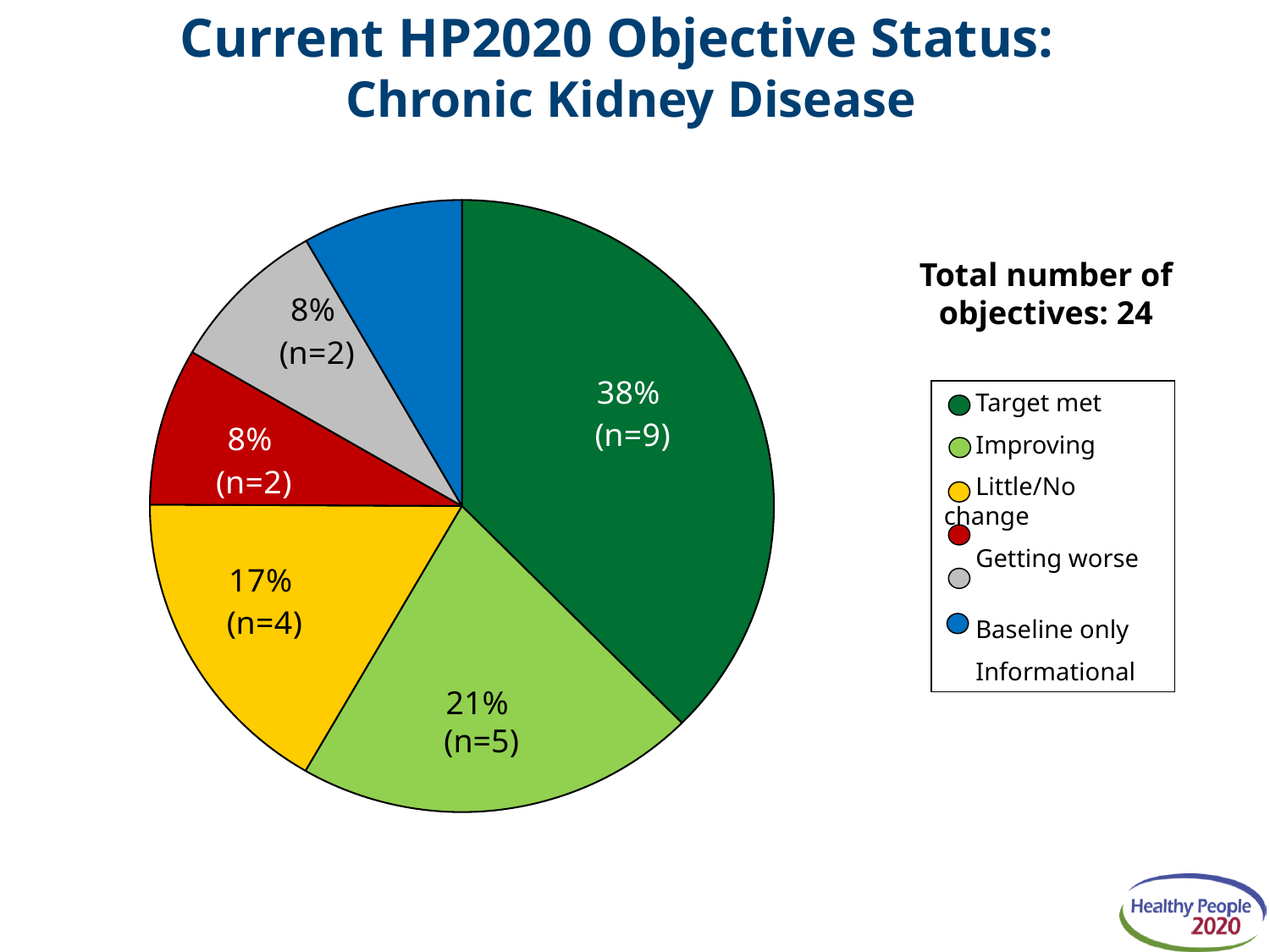
How many objectives are Getting worse? 2 How many status categories does the legend list? 6 Which status category has the largest share of the pie? Target met What is the difference in percentage points between the Target met share and the Improving share? 17 How many objectives are in the Improving category? 5 Which is larger, the share for Improving or the share for Little/No change? Improving Which colour represents the Getting worse category in the legend? red What percentage of objectives show Little/No change? 17% How many more objectives are in Target met than in Little/No change? 5 What percentage of objectives have the status Target met? 38% What kind of chart is shown on the slide? pie chart What is the total number of objectives stated on the slide? 24